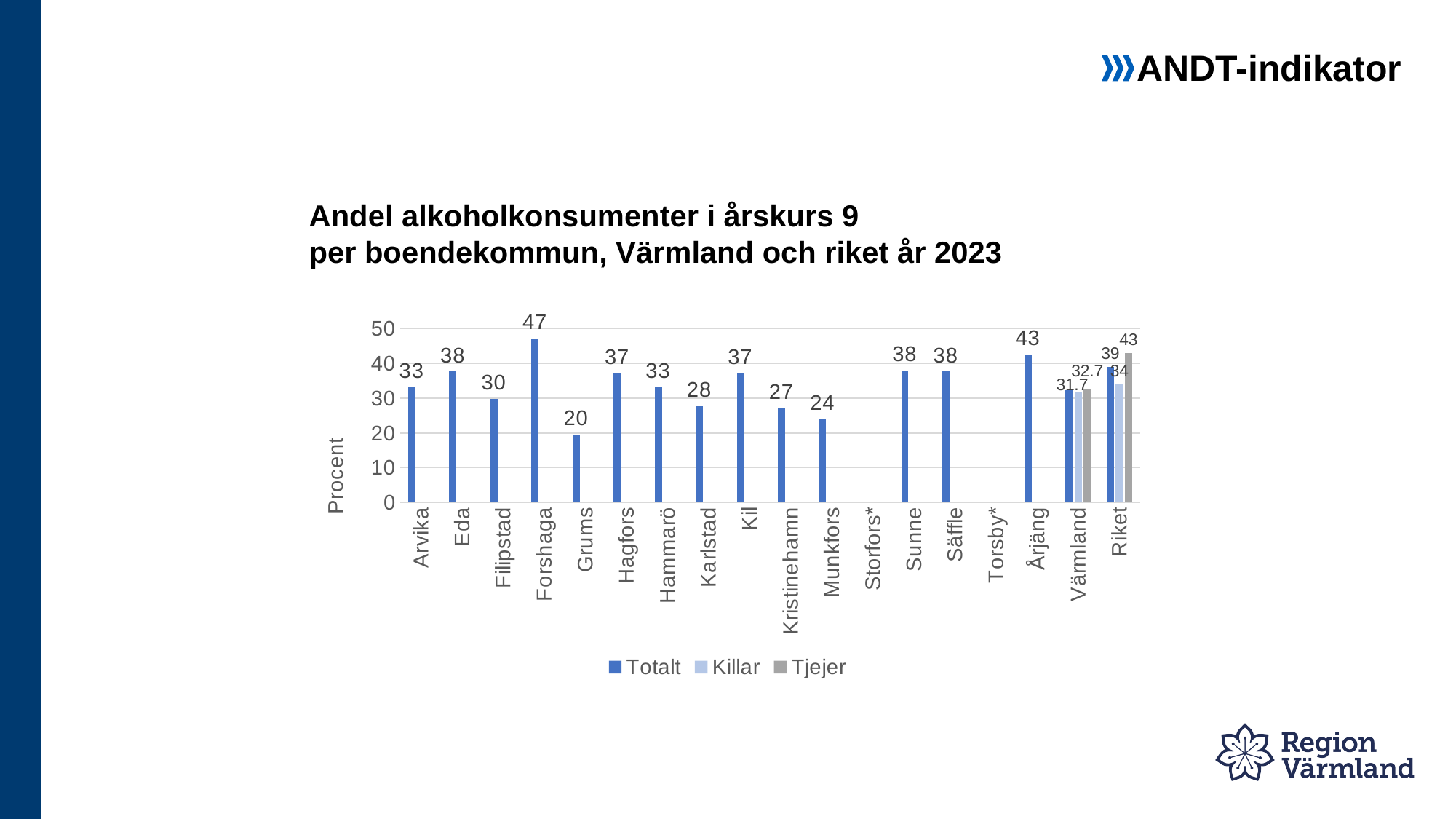
Which municipality has the lowest Totalt value among those with a bar? Grums What is the difference between the Totalt values for Forshaga and Grums? 27 What is the difference between the Tjejer and Killar values for Riket? 9 What is the label on the vertical axis? Procent What is the Killar value for Riket? 34 What is the Tjejer value for Riket? 43 How many series does the legend list? 3 What kind of chart is shown on the slide? Bar chart Which municipality has the highest Totalt value? Forshaga Which has a higher Totalt value, Eda or Filipstad? Eda What is the Killar value for Värmland? 31.7 What is the Totalt value for Forshaga? 47